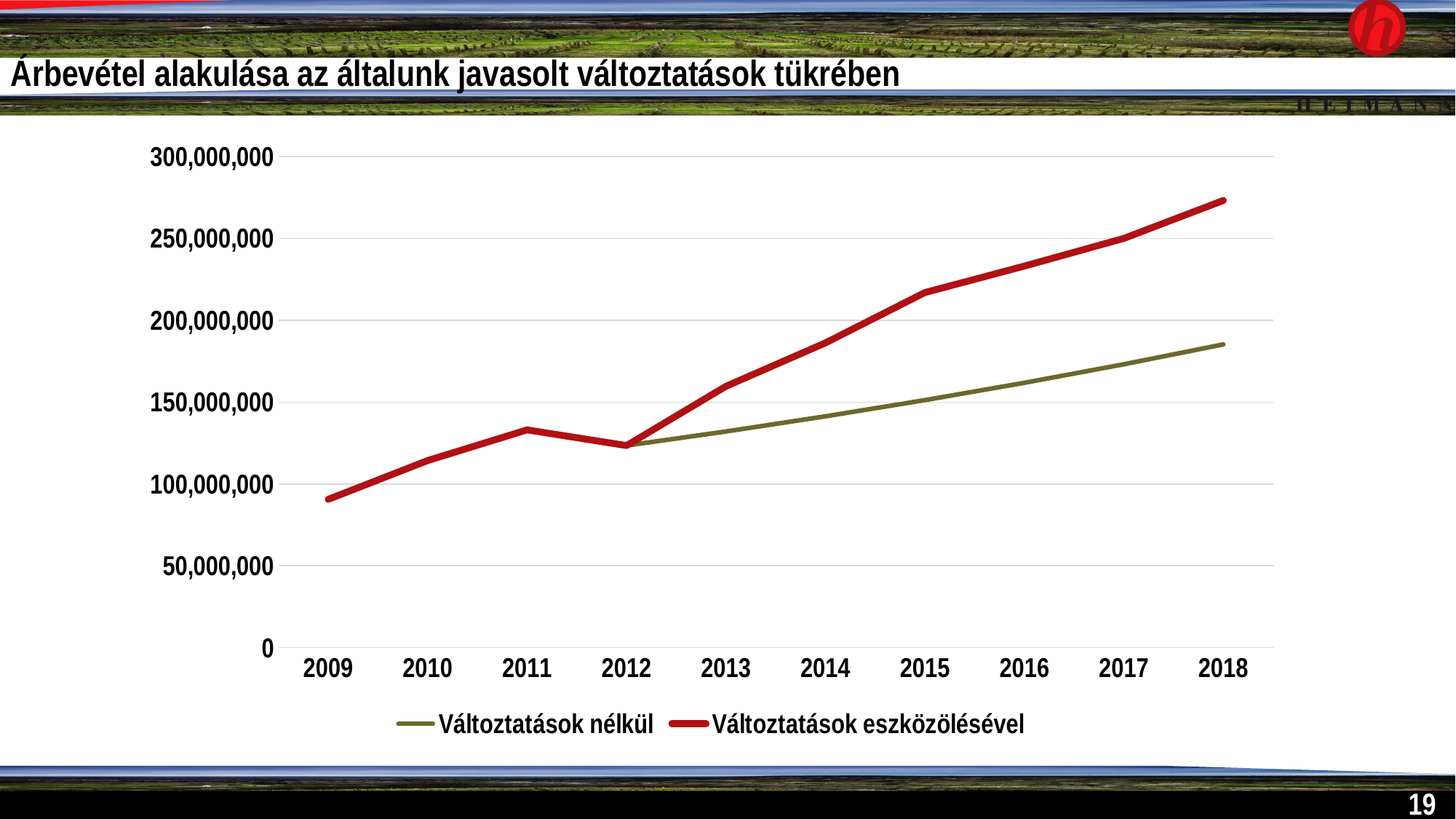
Which series is drawn in red? Változtatások eszközölésével How many series does the legend list? 2 Does the Változtatások nélkül series rise or fall from 2012 to 2018? rise In which year does the Változtatások eszközölésével series reach its highest value? 2018 Is the value for Változtatások eszközölésével in 2018 greater or less than 250,000,000? greater What kind of chart is shown on the slide? line chart In 2018, which series has the larger value, Változtatások nélkül or Változtatások eszközölésével? Változtatások eszközölésével Is the value for Változtatások nélkül in 2018 greater or less than 200,000,000? less What is the title of the slide's chart? Árbevétel alakulása az általunk javasolt változtatások tükrében How many years are shown on the x axis? 10 Is the value for Változtatások eszközölésével in 2009 greater or less than 100,000,000? less